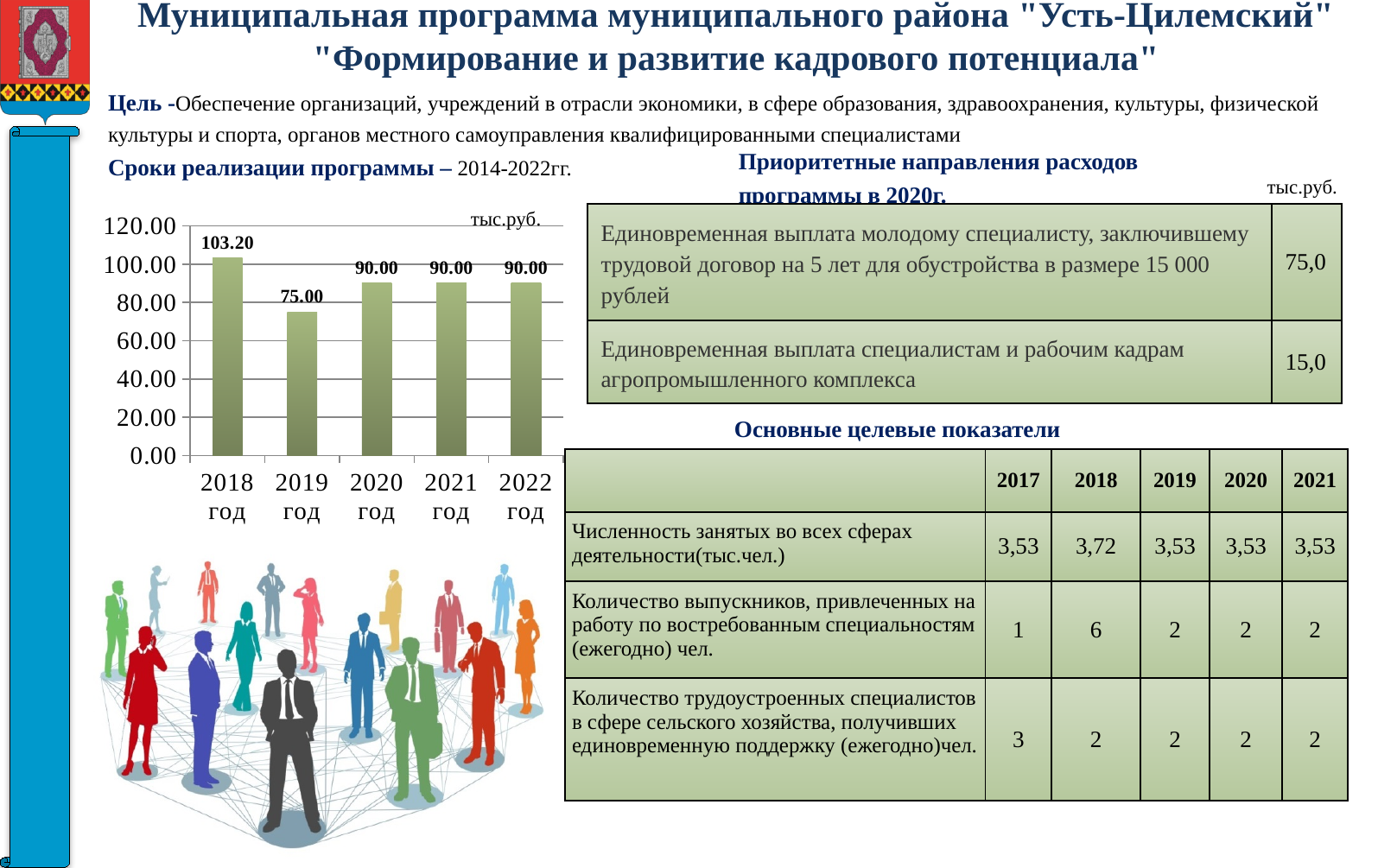
What type of chart is shown on the slide? bar chart What is the value for 2018 год on the bar chart? 103.20 What is the value for 2022 год on the bar chart? 90.00 What is the value for 2019 год on the bar chart? 75.00 Which year has the highest value on the bar chart? 2018 год Is the value for 2019 год on the bar chart greater or less than 80.00? less What unit is indicated above the bar chart? тыс.руб. What is the difference between the values for 2020 год and 2019 год on the bar chart? 15.00 What is the difference between the values for 2018 год and 2019 год on the bar chart? 28.20 How many years are shown on the bar chart? 5 Which is larger on the bar chart, the value for 2018 год or the value for 2020 год? 2018 год Which year has the lowest value on the bar chart? 2019 год